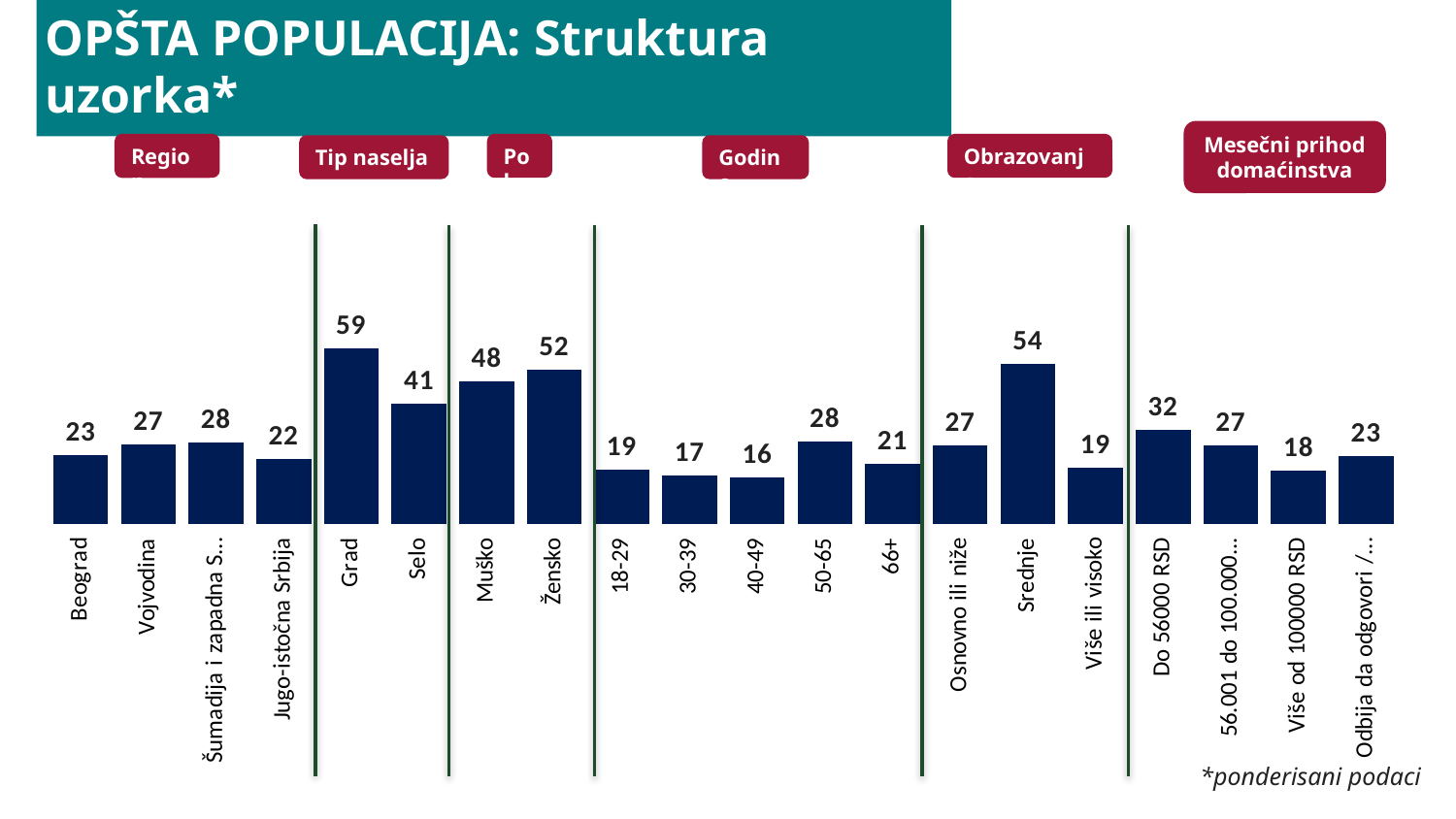
What is the value for Beograd? 23 What is the value for Srednje? 54 Which is larger, the value for Muško or the value for Žensko? Žensko Which category has the highest value on the chart? Grad What is the difference between the values for Srednje and Više ili visoko? 35 Which age group has the lowest value? 40-49 What is the difference between the values for Grad and Selo? 18 How many bars are plotted on the chart? 20 What is the value for the 40-49 age group? 16 What is the value for Grad? 59 What is the value for Više od 100000 RSD? 18 What type of chart is shown on the slide? Bar chart